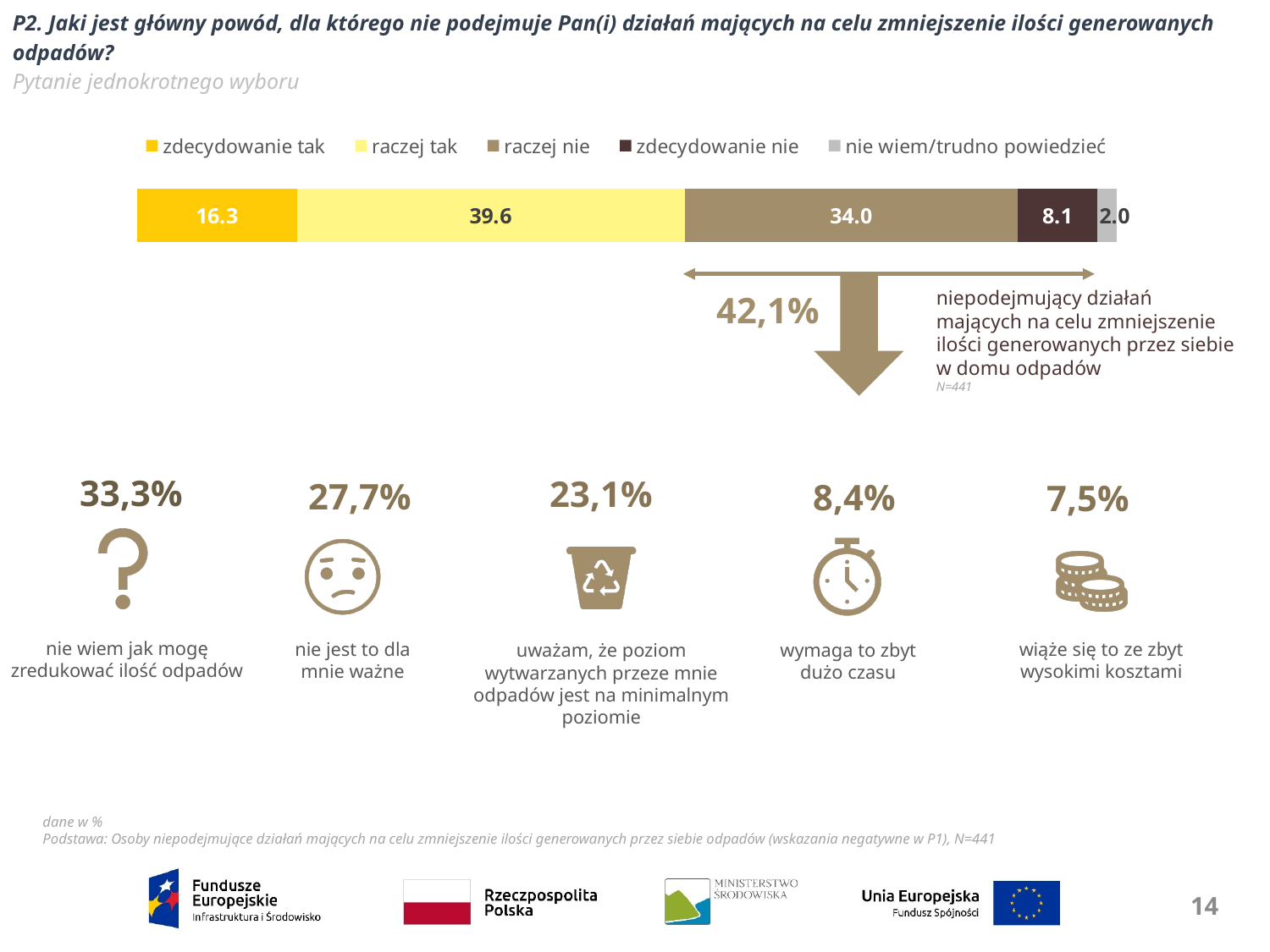
What kind of chart is shown at the top of the slide? stacked bar chart In the stacked bar chart, what is the value for "zdecydowanie tak"? 16.3 In the stacked bar chart, what is the value for "zdecydowanie nie"? 8.1 What is the total of all segments in the stacked bar? 100.0 How many series does the legend of the stacked bar chart list? 5 Which segment of the stacked bar has the lowest value? nie wiem/trudno powiedzieć What is the difference between the values for "raczej nie" and "zdecydowanie nie" in the stacked bar chart? 25.9 What is the difference between the values for "raczej tak" and "raczej nie" in the stacked bar chart? 5.6 In the stacked bar chart, what is the value for "nie wiem/trudno powiedzieć"? 2.0 In the stacked bar chart, which is larger: "zdecydowanie tak" or "zdecydowanie nie"? zdecydowanie tak In the stacked bar chart, what is the value for "raczej tak"? 39.6 Which segment of the stacked bar has the highest value? raczej tak